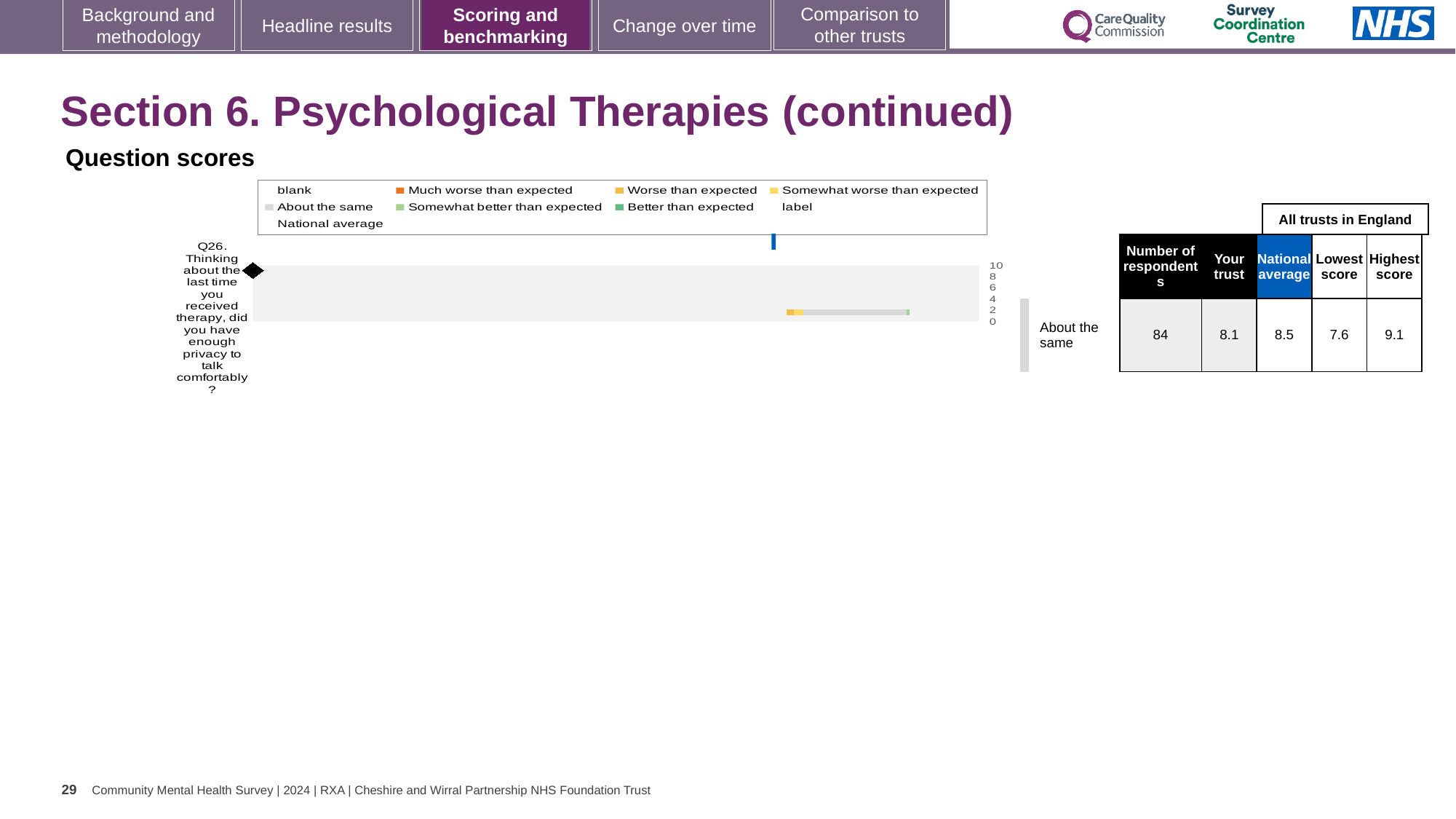
How many respondents answered Q26? 84 What is the difference between the national average and the trust's score for Q26? 0.4 According to the table, what is the highest score among all trusts in England for Q26? 9.1 What kind of chart is used to show the Q26 question score? bar chart What is the highest value shown on the chart's axis? 10 According to the table, what is the lowest score among all trusts in England for Q26? 7.6 According to the table next to the chart, what is the trust's score for Q26? 8.1 How many questions are plotted on the question scores chart? 1 What benchmark category is the trust's Q26 score placed in? About the same Which is larger for Q26, the trust's score or the national average? national average What is the difference between the highest score and the lowest score for Q26? 1.5 According to the table next to the chart, what is the national average score for Q26? 8.5